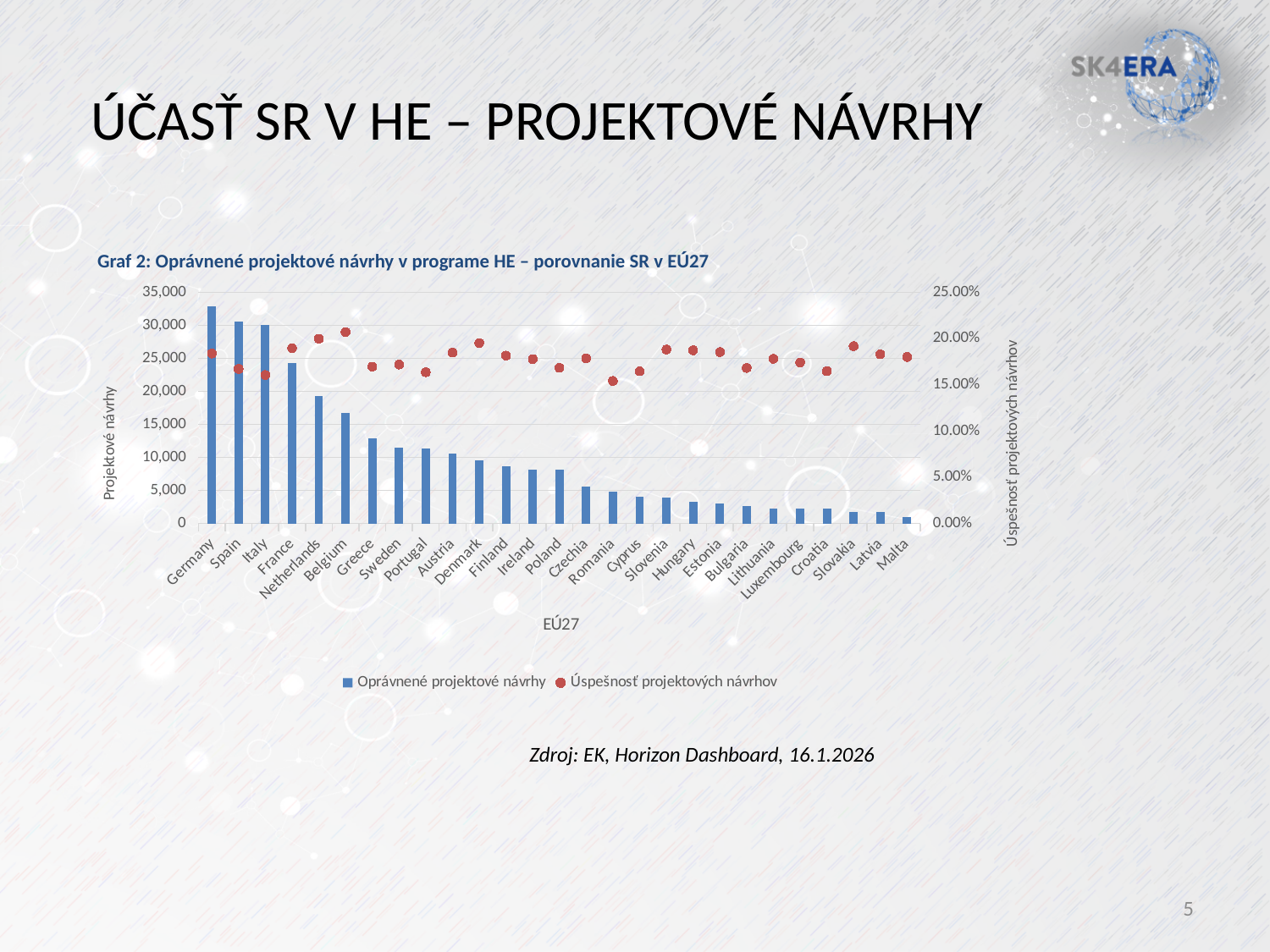
How many series does the chart legend list? 2 Is the Oprávnené projektové návrhy value for Finland greater or less than 10,000? less Is the Oprávnené projektové návrhy value for Slovakia greater or less than 5,000? less What kind of chart is shown on the slide? A bar chart combined with a dot (marker) series on a secondary axis How many countries are shown on the x axis of the chart? 27 Is the Oprávnené projektové návrhy value for Germany greater or less than 30,000? greater Which country has the lowest number of Oprávnené projektové návrhy (shortest bar)? Malta What is the title of the chart on the slide? Graf 2: Oprávnené projektové návrhy v programe HE – porovnanie SR v EÚ27 Do the bars for Oprávnené projektové návrhy rise or fall from left to right along the x axis? fall Which country has the highest number of Oprávnené projektové návrhy (tallest bar)? Germany Which has more Oprávnené projektové návrhy, France or Netherlands? France